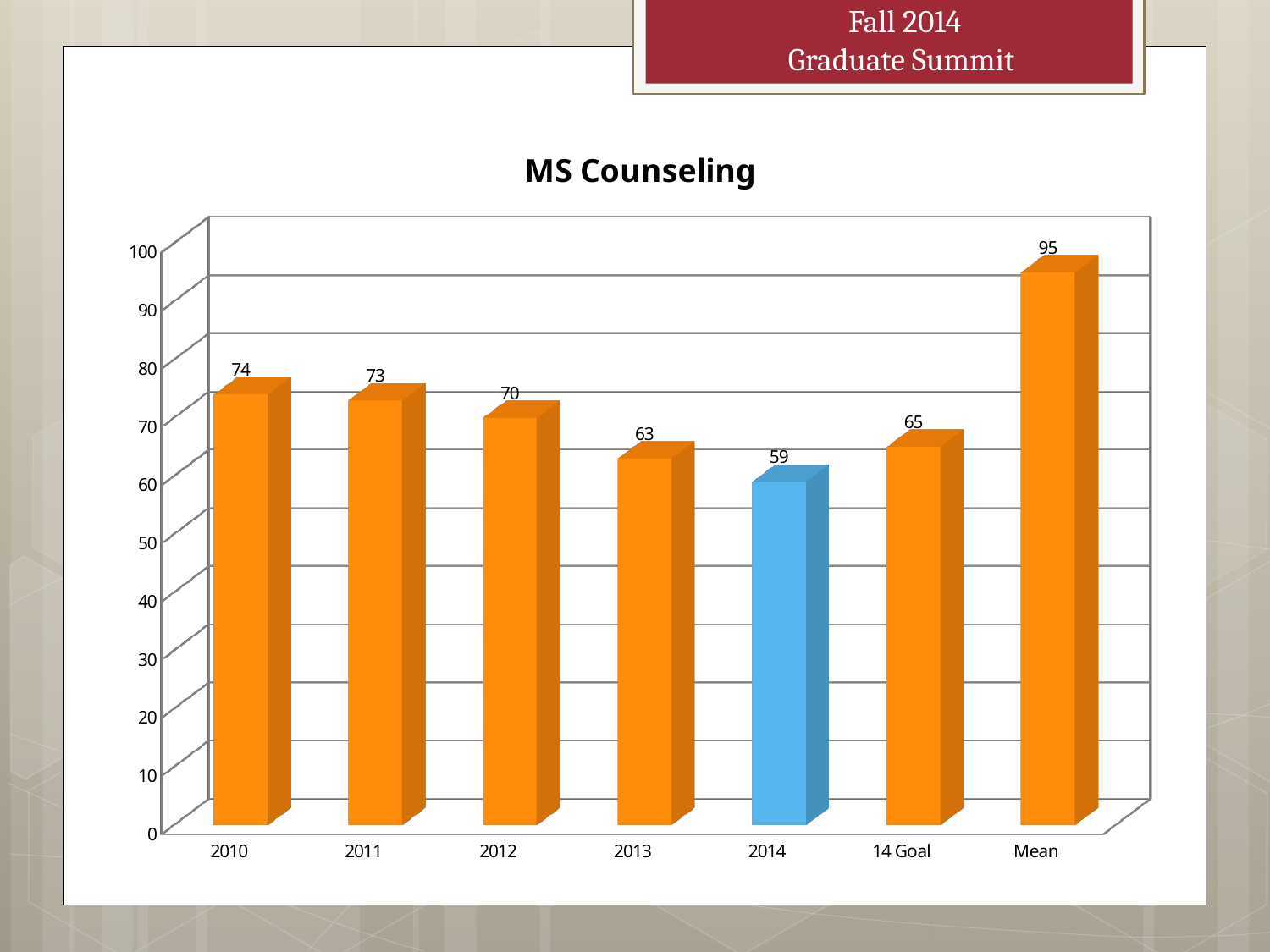
What is the difference between the Mean value and the 2014 value in the MS Counseling chart? 36 What is the value for 2014 in the MS Counseling chart? 59 Which category has the highest value in the MS Counseling chart? Mean What is the difference between the 14 Goal value and the 2014 value in the MS Counseling chart? 6 What kind of chart is shown on the slide? Bar chart Do the values rise or fall from 2010 to 2014 in the MS Counseling chart? Fall Which is larger in the MS Counseling chart, the value for 2011 or the value for 2013? 2011 What is the value for 2010 in the MS Counseling chart? 74 Is the value for 2012 in the MS Counseling chart greater or less than 60? greater How many bars are shown in the MS Counseling chart? 7 What is the value for 14 Goal in the MS Counseling chart? 65 Which category has the lowest value in the MS Counseling chart? 2014